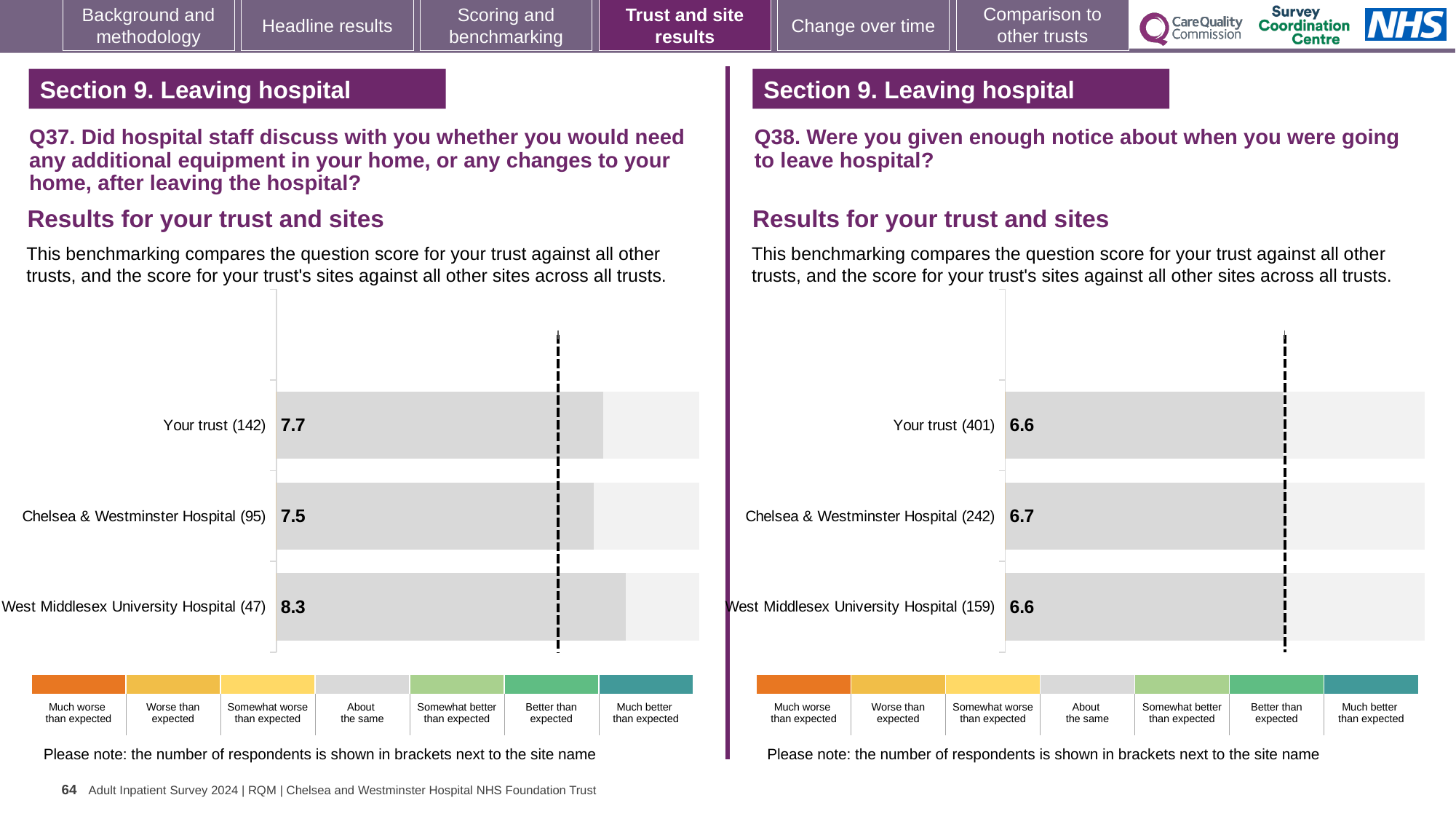
On the Q37 chart (left), how many bars are plotted? 3 On the Q37 chart (left), what is the score for Your trust (142)? 7.7 What kind of chart is used on the Q38 chart (right)? bar chart On the Q37 chart (left), which site or trust has the lowest score? Chelsea & Westminster Hospital (95) Is the score for Your trust on the Q37 chart (left) larger or smaller than the score for Your trust on the Q38 chart (right)? larger On the Q37 chart (left), what is the difference between the scores for West Middlesex University Hospital (47) and Chelsea & Westminster Hospital (95)? 0.8 On the Q38 chart (right), what is the score for Your trust (401)? 6.6 On the Q37 chart (left), what is the score for West Middlesex University Hospital (47)? 8.3 How many respondents are shown in brackets for West Middlesex University Hospital on the Q38 chart (right)? 159 On the Q37 chart (left), which site or trust has the highest score? West Middlesex University Hospital (47) On the Q38 chart (right), what is the difference between the scores for Chelsea & Westminster Hospital (242) and West Middlesex University Hospital (159)? 0.1 On the Q38 chart (right), what is the score for Chelsea & Westminster Hospital (242)? 6.7